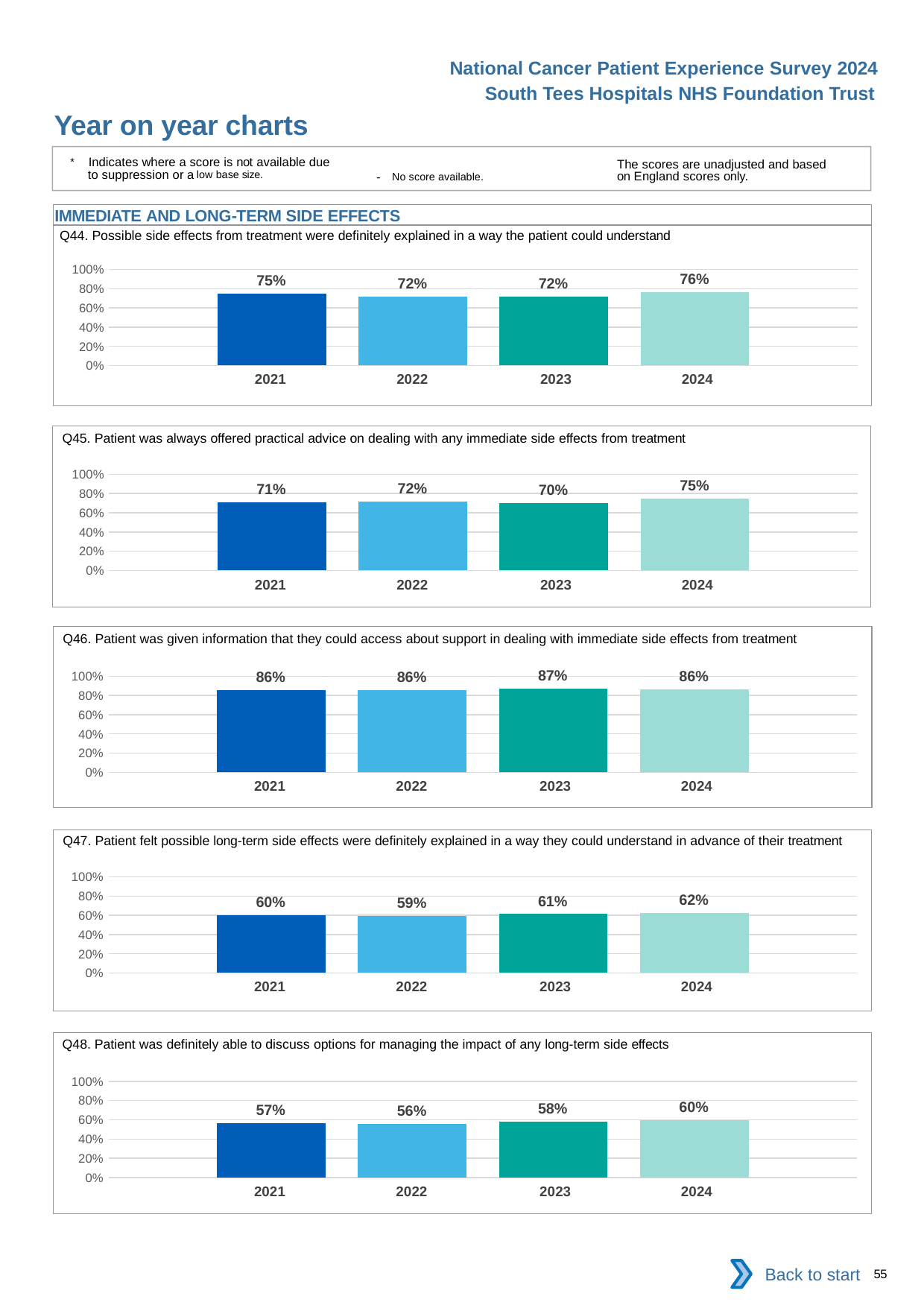
In the Q47 chart, which year has the lowest value? 2022 In the Q45 chart, what is the value for 2023? 70% In the Q48 chart, is the value for 2024 larger than the value for 2022? Yes In the Q48 chart, what is the difference between the 2024 and 2021 values? 3 percentage points What kind of chart is the Q48 chart? Bar chart In the Q46 chart, how many years are shown? 4 In the Q48 chart, is the value for 2022 greater or less than 60%? less In the Q44 chart, what is the value for 2024? 76% In the Q45 chart, what is the difference between the 2024 and 2021 values? 4 percentage points In the Q44 chart, which year has the highest value? 2024 In the Q46 chart, which year has the highest value? 2023 In the Q47 chart, what is the value for 2021? 60%